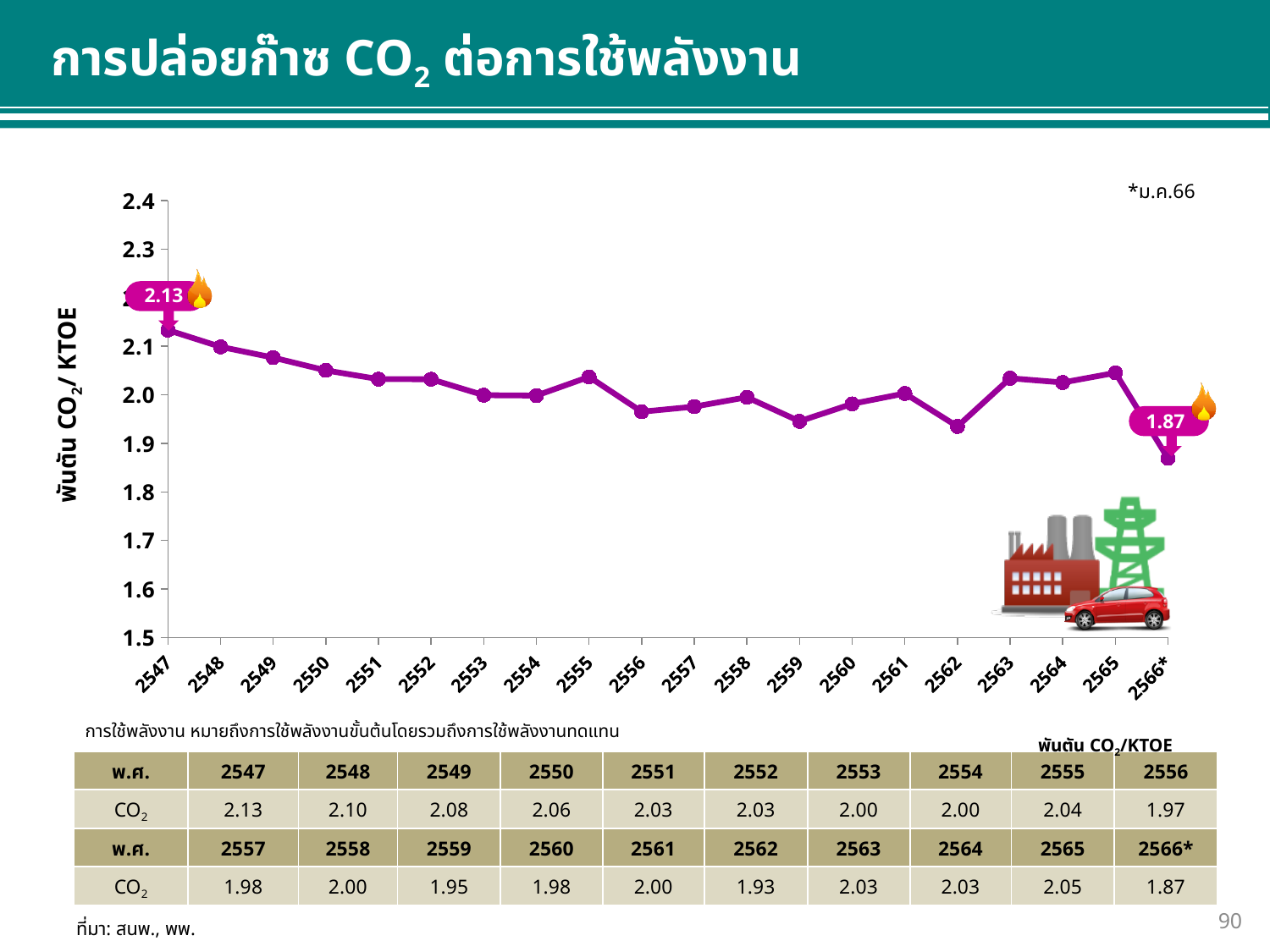
Is the value for 2562 greater or less than 2.0? less What is the value shown for 2566*? 1.87 Which year has the lowest value on the chart? 2566* What is the value for 2562? 1.93 What is the value for 2559 according to the table below the chart? 1.95 Which is larger, the value for 2562 or the value for 2563? 2563 Which year has the highest value on the chart? 2547 What is the difference between the values for 2547 and 2566*? 0.26 What is the CO2 emission per energy use value for 2547? 2.13 Overall, do the values rise or fall from 2547 to 2566*? fall How many years are plotted on the x axis of the chart? 20 What kind of chart is shown on the slide? line chart